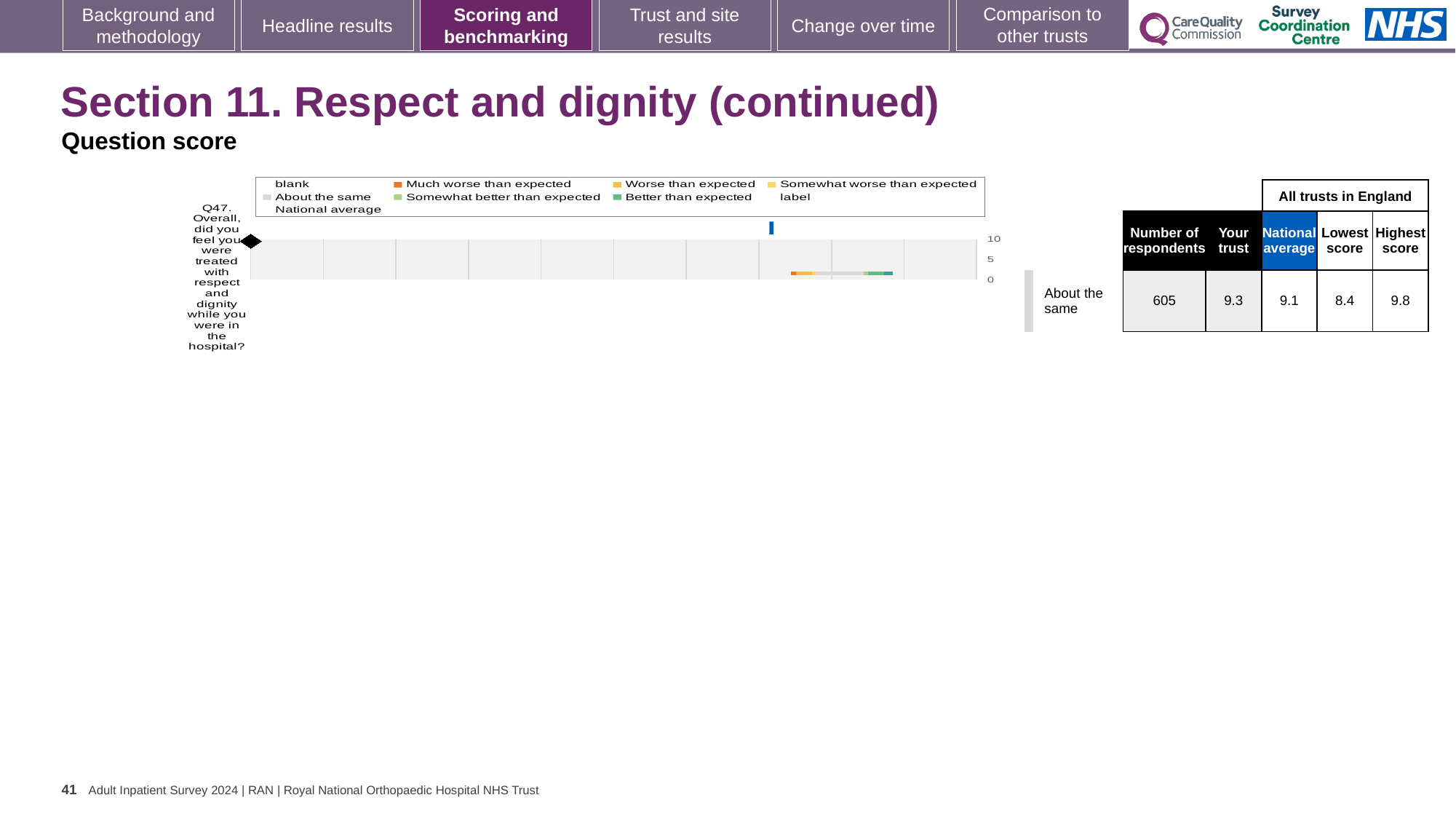
How many respondents answered Q47? 605 What is the highest score among all trusts in England for Q47? 9.8 What kind of chart is shown on the slide? bar chart How many questions (categories) are plotted in the chart? 1 What colour does the legend use for 'Much worse than expected'? orange What is the difference between the highest score and the lowest score for Q47? 1.4 What benchmark category is the trust's Q47 result labelled as? About the same What is the national average score for Q47 shown in the table next to the chart? 9.1 What is the lowest score among all trusts in England for Q47? 8.4 Which is larger for Q47, the 'Your trust' score or the national average? Your trust Is the 'Your trust' score for Q47 greater or less than 5 on the chart's axis? greater What is the 'Your trust' score for Q47 shown in the table next to the chart? 9.3